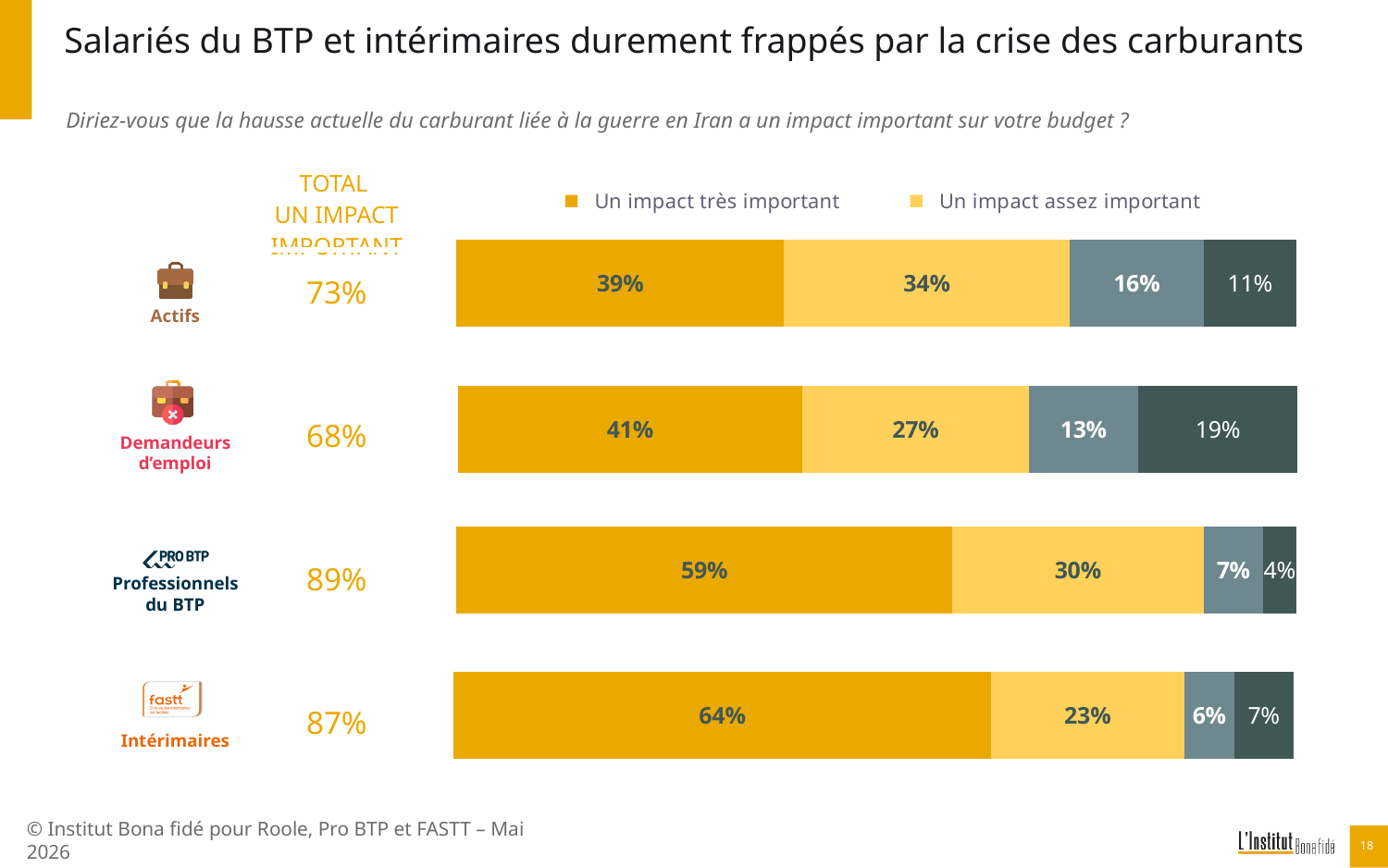
What is the first legend entry of the chart? Un impact très important What is the sum of the 'Un impact très important' and 'Un impact assez important' values for Intérimaires? 87% What is the 'Un impact assez important' value for Demandeurs d'emploi? 27% What is the difference between the 'Un impact très important' values for Intérimaires and Actifs? 25 points How many series does the legend list? 2 Which group has the highest 'Un impact très important' share? Intérimaires How many groups (categories) are shown in the chart? 4 What is the TOTAL UN IMPACT IMPORTANT figure shown for Professionnels du BTP? 89% What kind of chart is shown on the slide? Stacked bar chart Which group has the lowest TOTAL UN IMPACT IMPORTANT figure? Demandeurs d'emploi Which is larger: the 'Un impact assez important' share for Actifs or for Intérimaires? Actifs What percentage of Actifs say the fuel price rise has 'un impact très important' on their budget? 39%